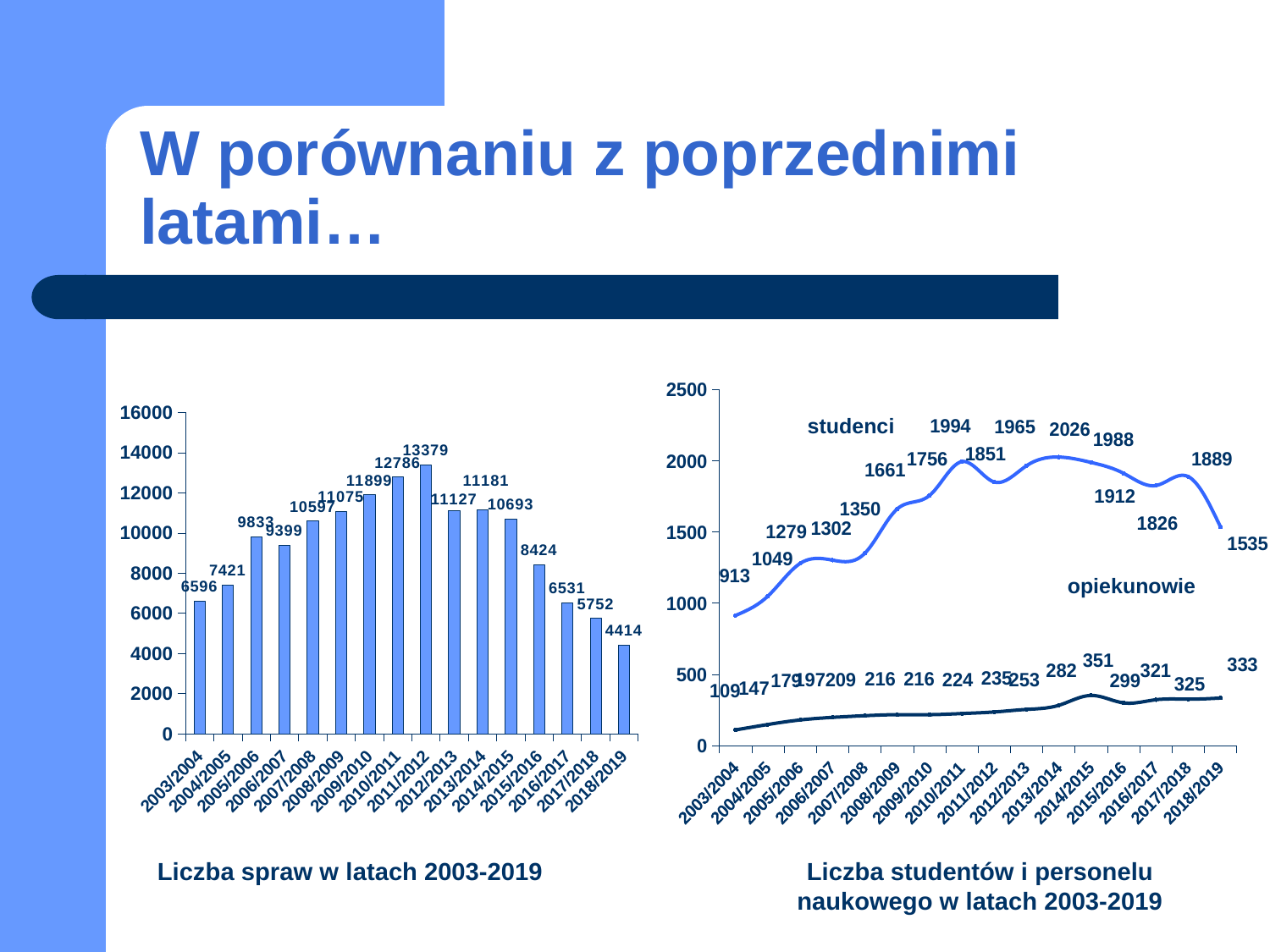
In the chart 'Liczba spraw w latach 2003-2019', what is the difference between the values for 2003/2004 and 2018/2019? 2182 In the chart 'Liczba studentów i personelu naukowego w latach 2003-2019', which year has the highest value for opiekunowie? 2014/2015 In the chart 'Liczba spraw w latach 2003-2019', how many years are shown on the x axis? 16 In the chart 'Liczba spraw w latach 2003-2019', which year has the highest value? 2011/2012 In the chart 'Liczba spraw w latach 2003-2019', which year has the lowest value? 2018/2019 In the chart 'Liczba spraw w latach 2003-2019', what is the value for 2011/2012? 13379 What kind of chart is 'Liczba studentów i personelu naukowego w latach 2003-2019'? line chart In the chart 'Liczba studentów i personelu naukowego w latach 2003-2019', how many series are plotted? 2 In the chart 'Liczba studentów i personelu naukowego w latach 2003-2019', what is the value for studenci in 2013/2014? 2026 What kind of chart is 'Liczba spraw w latach 2003-2019'? bar chart In the chart 'Liczba spraw w latach 2003-2019', do the values rise or fall from 2011/2012 to 2018/2019? fall In the chart 'Liczba studentów i personelu naukowego w latach 2003-2019', what is the value for opiekunowie in 2018/2019? 333